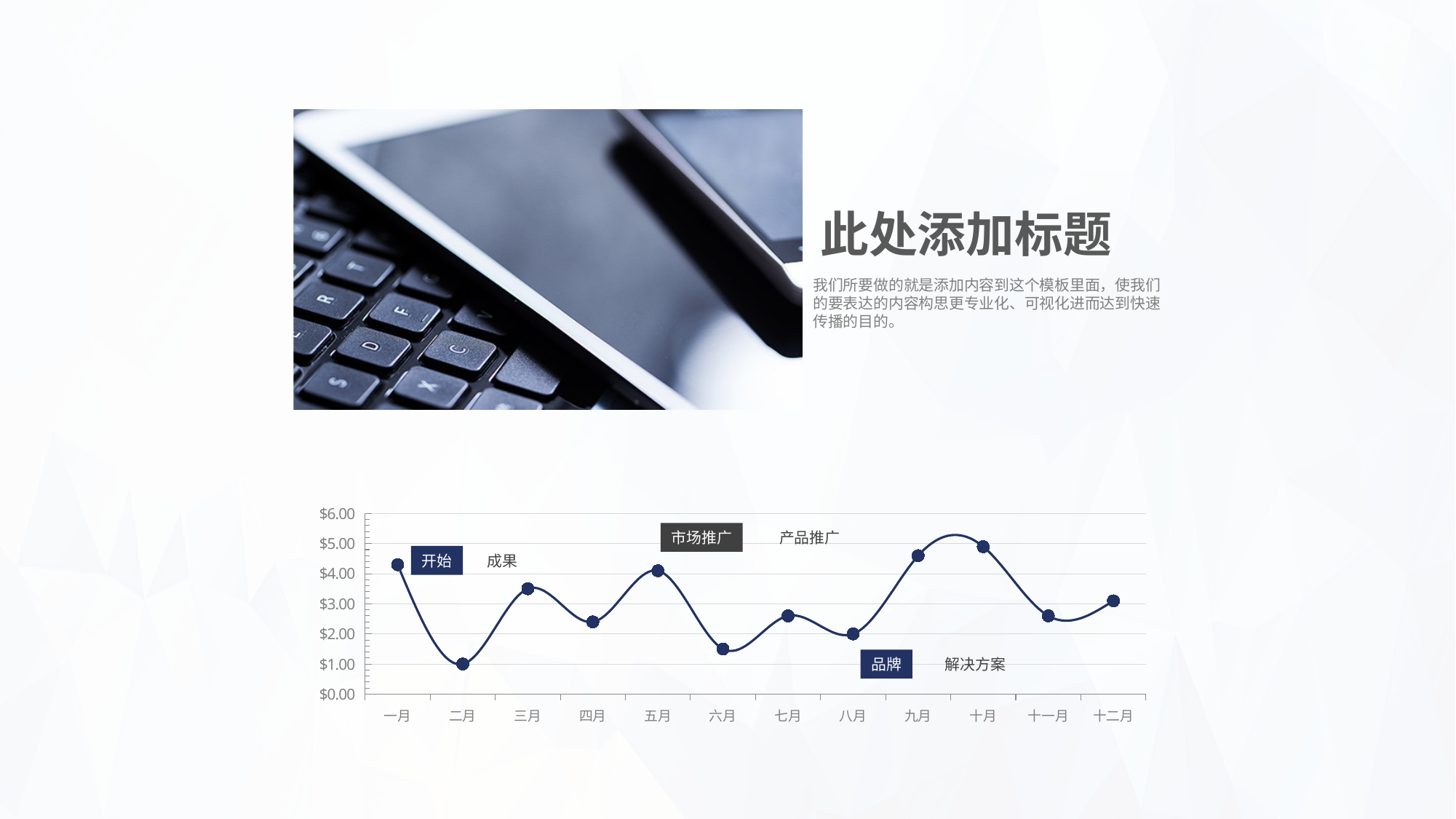
Does the line rise or fall from 一月 to 二月? fall Is the value for 一月 greater or less than $4.00? greater What kind of chart is shown on the slide? line chart How many months are plotted along the x axis of the chart? 12 What is the highest value shown on the chart's y axis? $6.00 Which month has the lowest value on the chart? 二月 Is the value for 六月 greater or less than $2.00? less Is the value for 九月 greater or less than $4.00? greater Which is larger, the value for 五月 or the value for 六月? 五月 Which is larger, the value for 一月 or the value for 二月? 一月